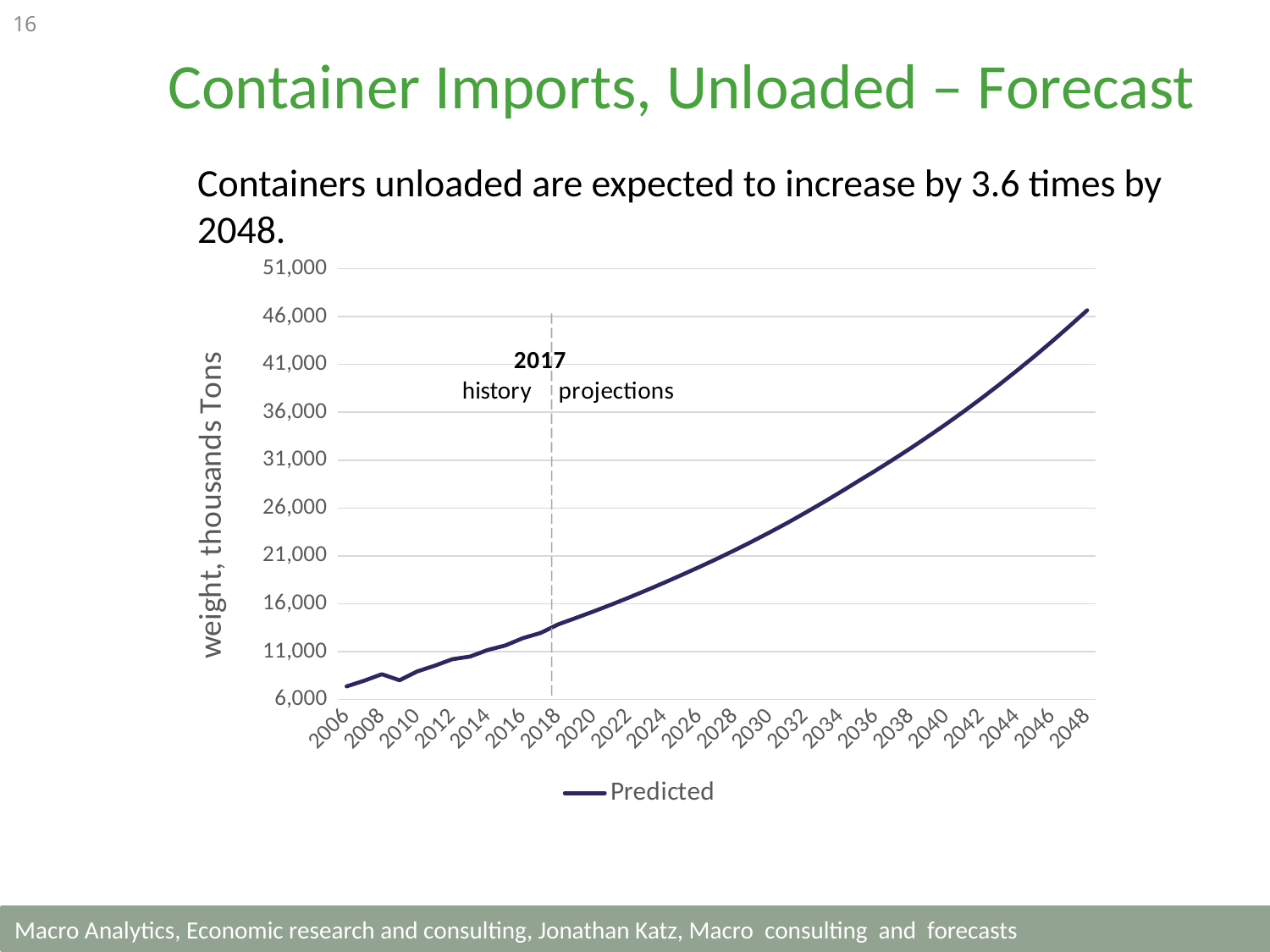
Is the value for 2030 greater or less than 21,000? greater What is the label on the vertical axis? weight, thousands Tons What is the name of the series shown in the legend? Predicted Which year has the larger value, 2024 or 2040? 2040 What kind of chart is shown on the slide? line chart Is the value for 2020 greater or less than 16,000? less How many series does the legend list? 1 Is the value for 2048 greater or less than 41,000? greater Do the values rise or fall along the x axis from 2006 to 2048? rise Which year has the highest value on the chart? 2048 Which year has the lowest value on the chart? 2006